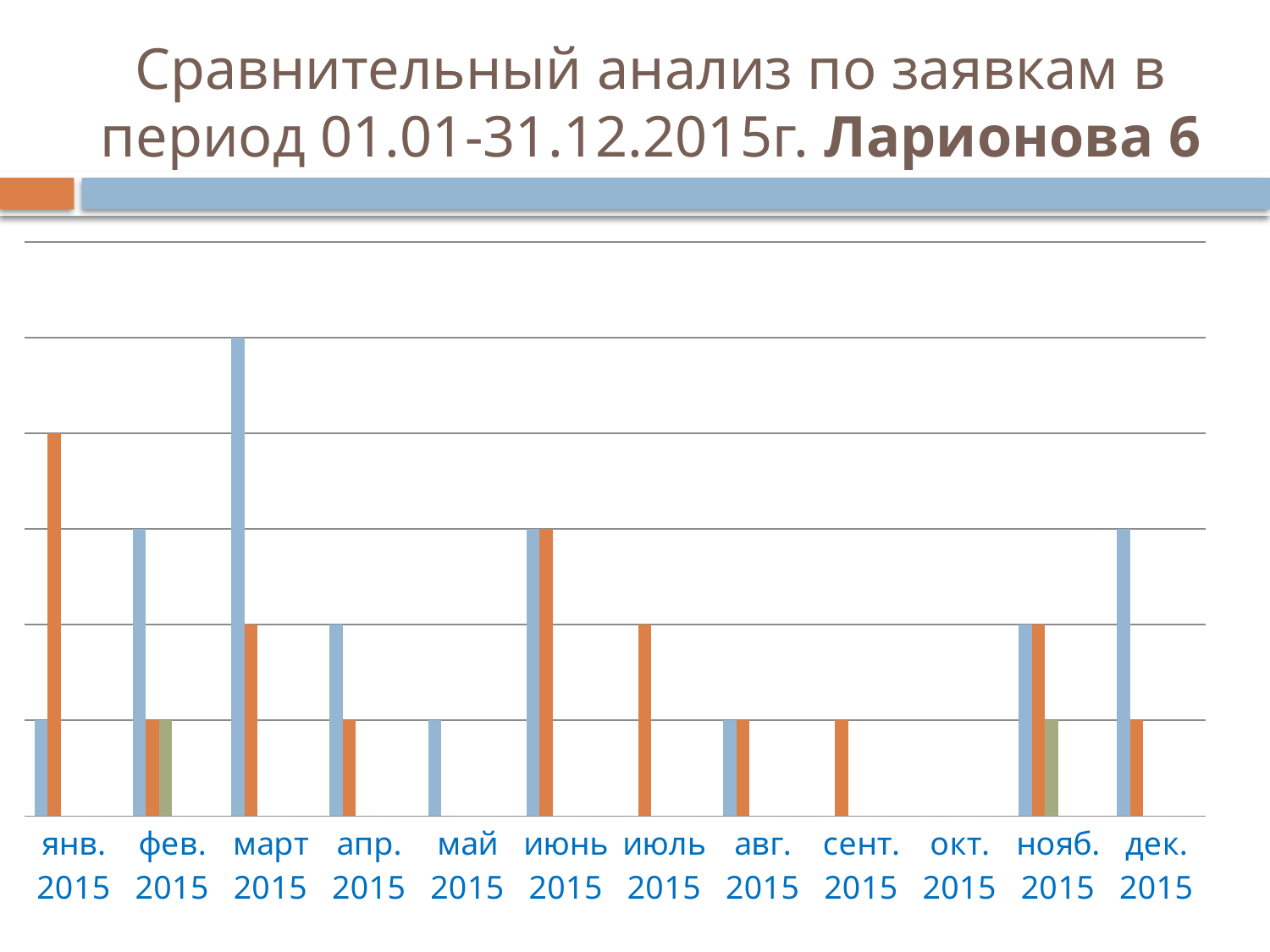
Which month has the tallest blue bar? март 2015 Which month has the tallest orange bar? янв. 2015 Which is taller, the orange bar for июль 2015 or the orange bar for авг. 2015? июль 2015 What is the title of the slide? Сравнительный анализ по заявкам в период 01.01-31.12.2015г. Ларионова 6 In март 2015, which bar is taller, the blue one or the orange one? Blue Which is taller, the blue bar for дек. 2015 or the blue bar for нояб. 2015? дек. 2015 What kind of chart is shown on the slide? Bar chart Which months have a green bar? фев. 2015 and нояб. 2015 Which month has no bars at all? окт. 2015 How many months are shown along the x axis of the chart? 12